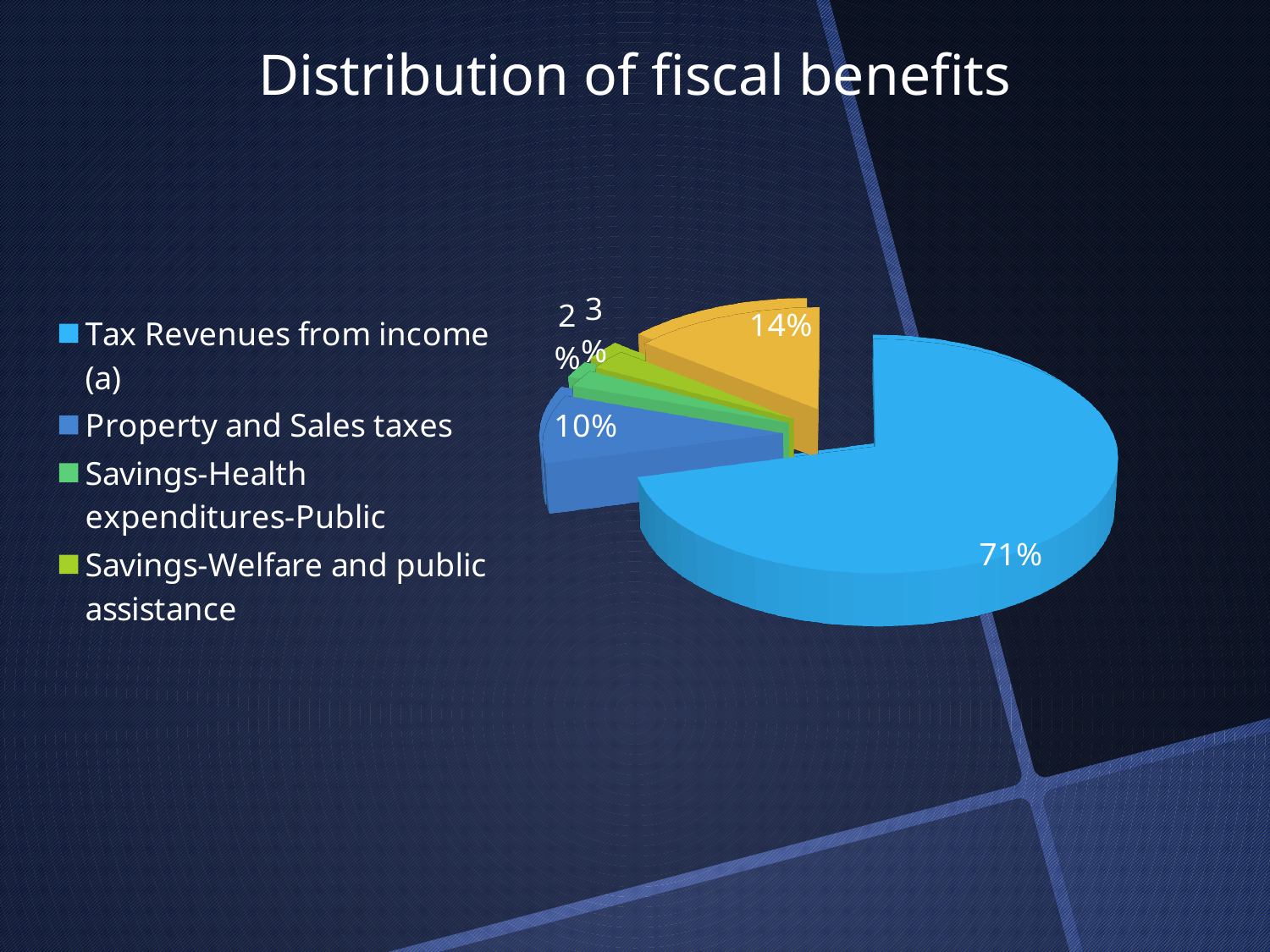
Which category has the largest slice of the pie? Tax Revenues from income (a) What is the title of the chart? Distribution of fiscal benefits What is the value shown for Property and Sales taxes? 10% Which category has the smallest slice of the pie? Savings-Health expenditures-Public What type of chart is shown on the slide? pie chart How many entries does the legend list? 4 What is the value shown for Savings-Health expenditures-Public? 2% What is the value shown for Savings-Welfare and public assistance? 3% How many slices does the pie chart have? 5 Which is larger: Property and Sales taxes or Savings-Welfare and public assistance? Property and Sales taxes What is the difference between the Tax Revenues from income (a) slice and the Property and Sales taxes slice? 61 percentage points What share of the pie is Tax Revenues from income (a)? 71%